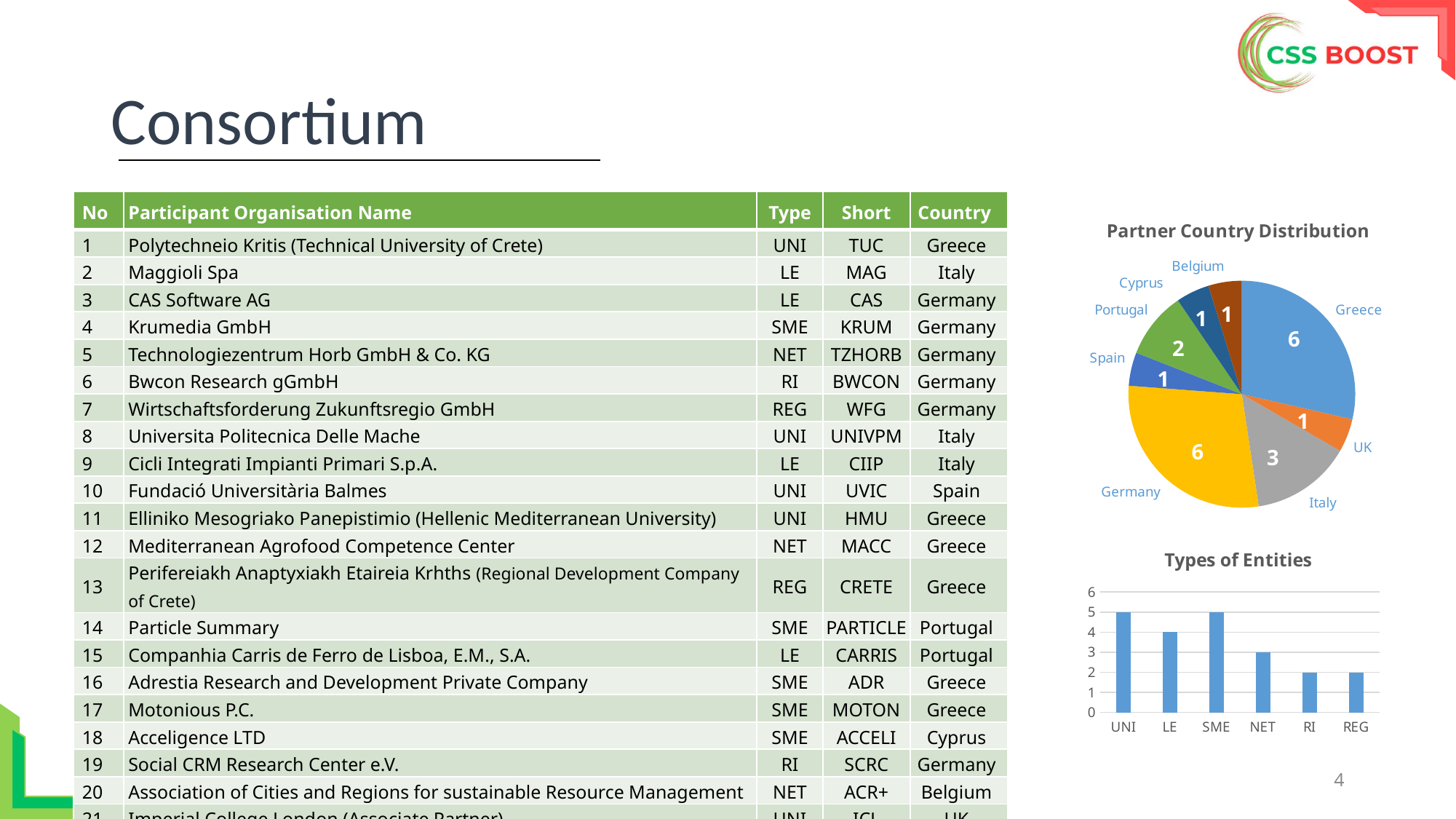
In the Partner Country Distribution pie chart, what is the difference between the number of partners from Greece and from Italy? 3 In the Types of Entities chart, what is the value for NET? 3 What kind of chart is the Types of Entities chart? Bar chart In the Types of Entities chart, which is larger, LE or NET? LE How many entity types are shown on the x axis of the Types of Entities chart? 6 In the Partner Country Distribution pie chart, how many partners are from Portugal? 2 In the Partner Country Distribution pie chart, how many partners are from Germany? 6 What kind of chart is the Partner Country Distribution chart? Pie chart How many countries are shown in the Partner Country Distribution pie chart? 8 In the Partner Country Distribution pie chart, how many partners are from Italy? 3 In the Partner Country Distribution pie chart, which has more partners, Germany or Italy? Germany In the Types of Entities chart, is the value for UNI greater or less than 4? greater